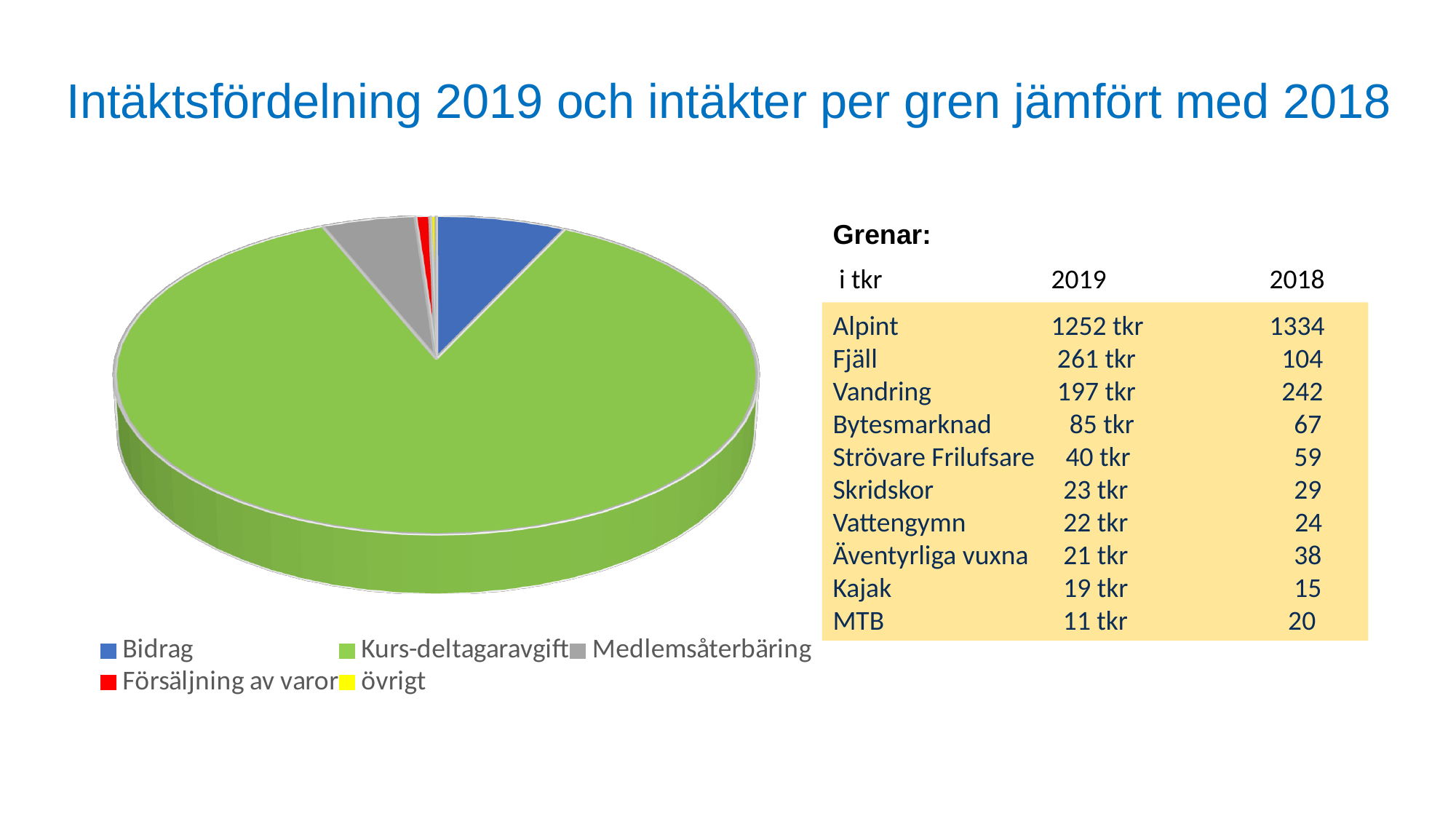
What is the title of the slide containing the pie chart? Intäktsfördelning 2019 och intäkter per gren jämfört med 2018 Which is larger in the pie chart, the slice for Bidrag or the slice for Medlemsåterbäring? Bidrag Which category has the largest slice in the pie chart? Kurs-deltagaravgift What kind of chart is shown on the slide? pie chart How many entries does the pie chart's legend list? 5 Which is larger in the pie chart, the slice for Medlemsåterbäring or the slice for övrigt? Medlemsåterbäring Which is larger in the pie chart, the slice for Bidrag or the slice for Kurs-deltagaravgift? Kurs-deltagaravgift What colour is the Bidrag slice in the pie chart? blue How many slices does the pie chart have? 5